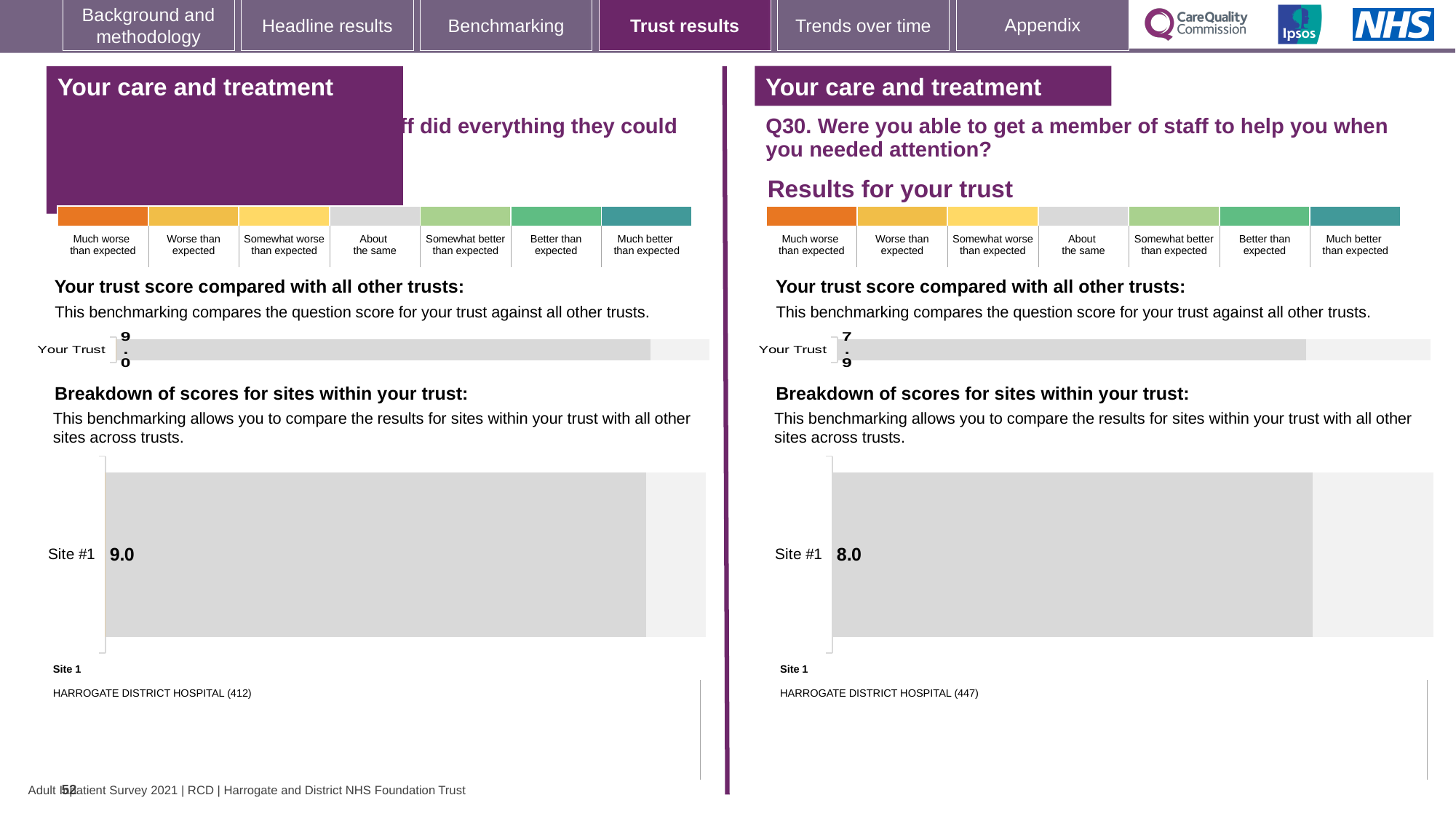
On the right-hand chart for Q30, what is the score shown for Your Trust? 7.9 On the left-hand chart, what is the score shown for Your Trust? 9.0 On the right-hand chart for Q30, what is the score shown for Site #1? 8.0 What is the difference between the Site #1 score on the left-hand chart and the Site #1 score on the right-hand chart for Q30? 1.0 Which is larger on the right-hand side for Q30: the Your Trust score or the Site #1 score? Site #1 (8.0) What type of chart is used to show the Site #1 score on the left-hand side? Bar chart On the left-hand chart, what is the score shown for Site #1? 9.0 Which hospital is listed as Site 1 on the right-hand side for Q30? HARROGATE DISTRICT HOSPITAL (447) How many sites are shown in the site breakdown chart on the right-hand side for Q30? 1 Which hospital is listed as Site 1 on the left-hand side? HARROGATE DISTRICT HOSPITAL (412) On the right-hand chart for Q30, what is the difference between the Site #1 score and the Your Trust score? 0.1 Which is larger: the Site #1 score on the left-hand chart or the Site #1 score on the right-hand chart for Q30? Left-hand chart (9.0)